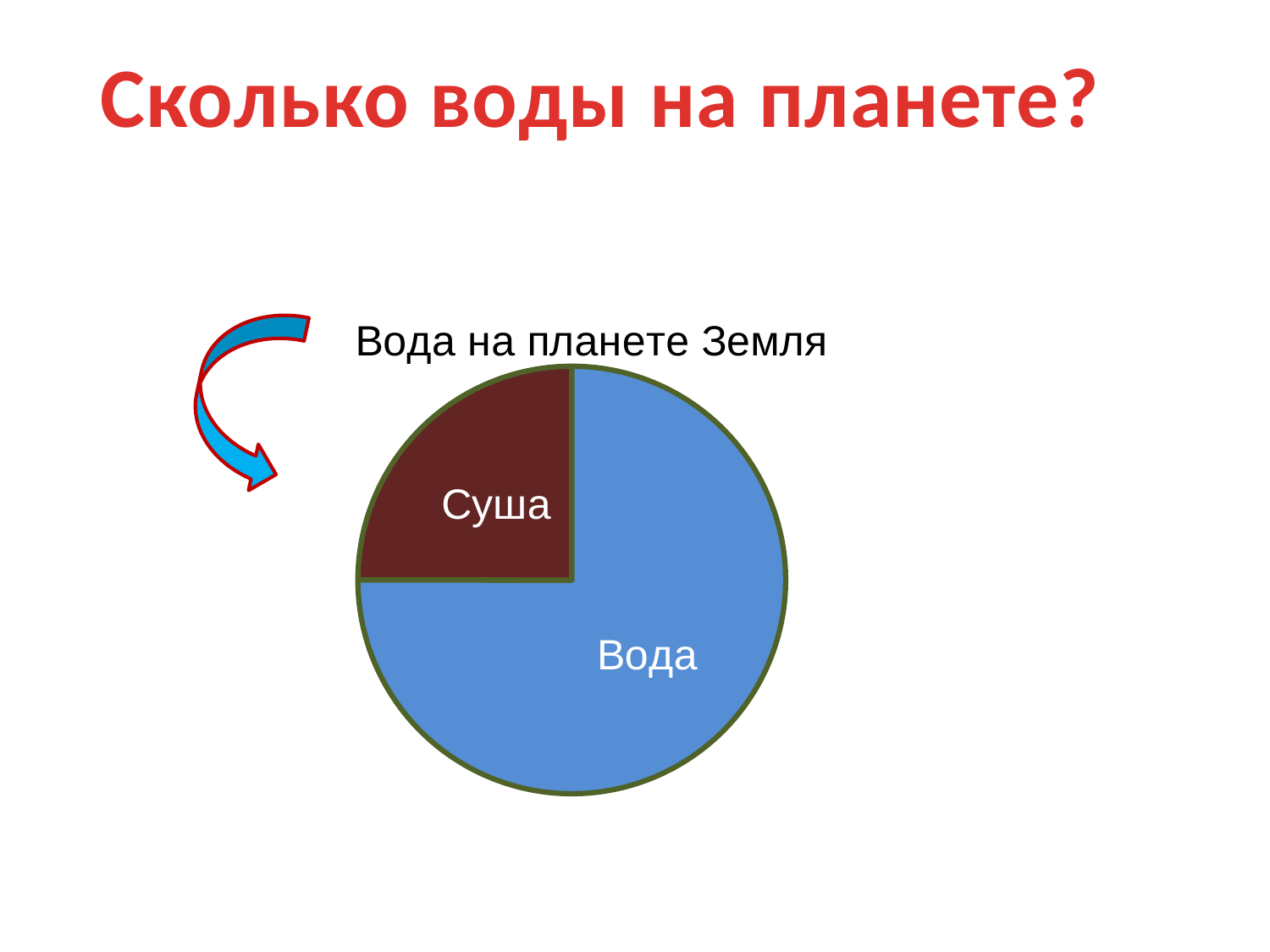
What is the title of the chart? Вода на планете Земля What kind of chart is shown on the slide? pie chart Does the Вода slice take up more or less than half of the pie? more How many slices does the pie chart have? 2 Which slice of the pie chart is the smallest? Суша Which slice is larger, Суша or Вода? Вода What colour is the Суша slice of the pie chart? dark red Which slice of the pie chart is the largest? Вода